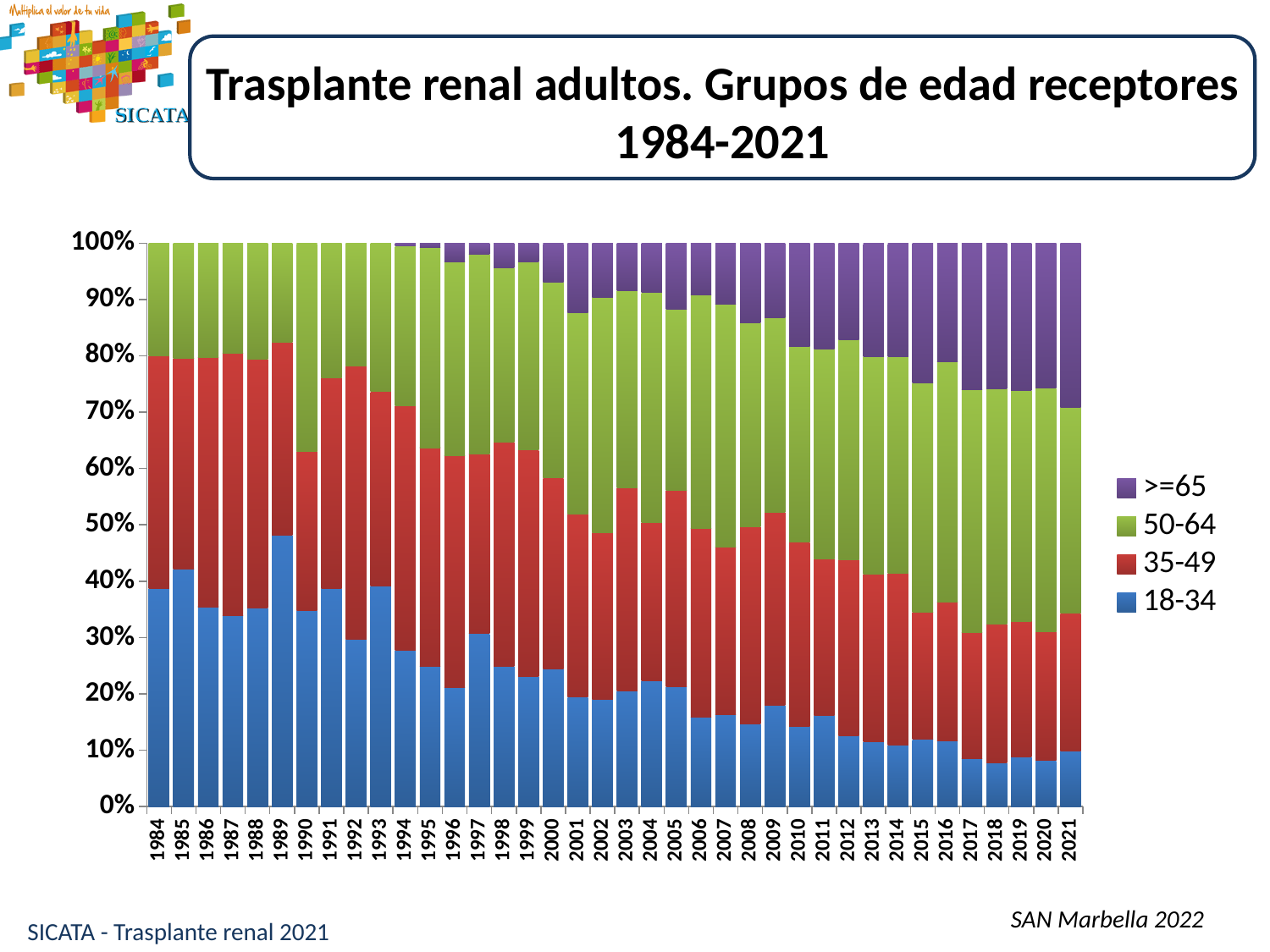
Does the share of the 18-34 group rise or fall from 1984 to 2021? Fall What are the four age groups listed in the legend? >=65, 50-64, 35-49, 18-34 How many series does the legend list? 4 How many years are shown along the x axis? 38 Which is larger, the share of the 18-34 group in 1984 or in 2021? 1984 Is the share of the 18-34 group in 2021 greater or less than 20%? less What kind of chart is shown on the slide? Stacked bar chart In which year is the share of the 18-34 group highest? 1989 Is the share of the 18-34 group in 1989 greater or less than 40%? greater Does the share of the >=65 group rise or fall from 1984 to 2021? Rise What is the title of the chart? Trasplante renal adultos. Grupos de edad receptores 1984-2021 What is the total of the stacked bar for 2021? 100%